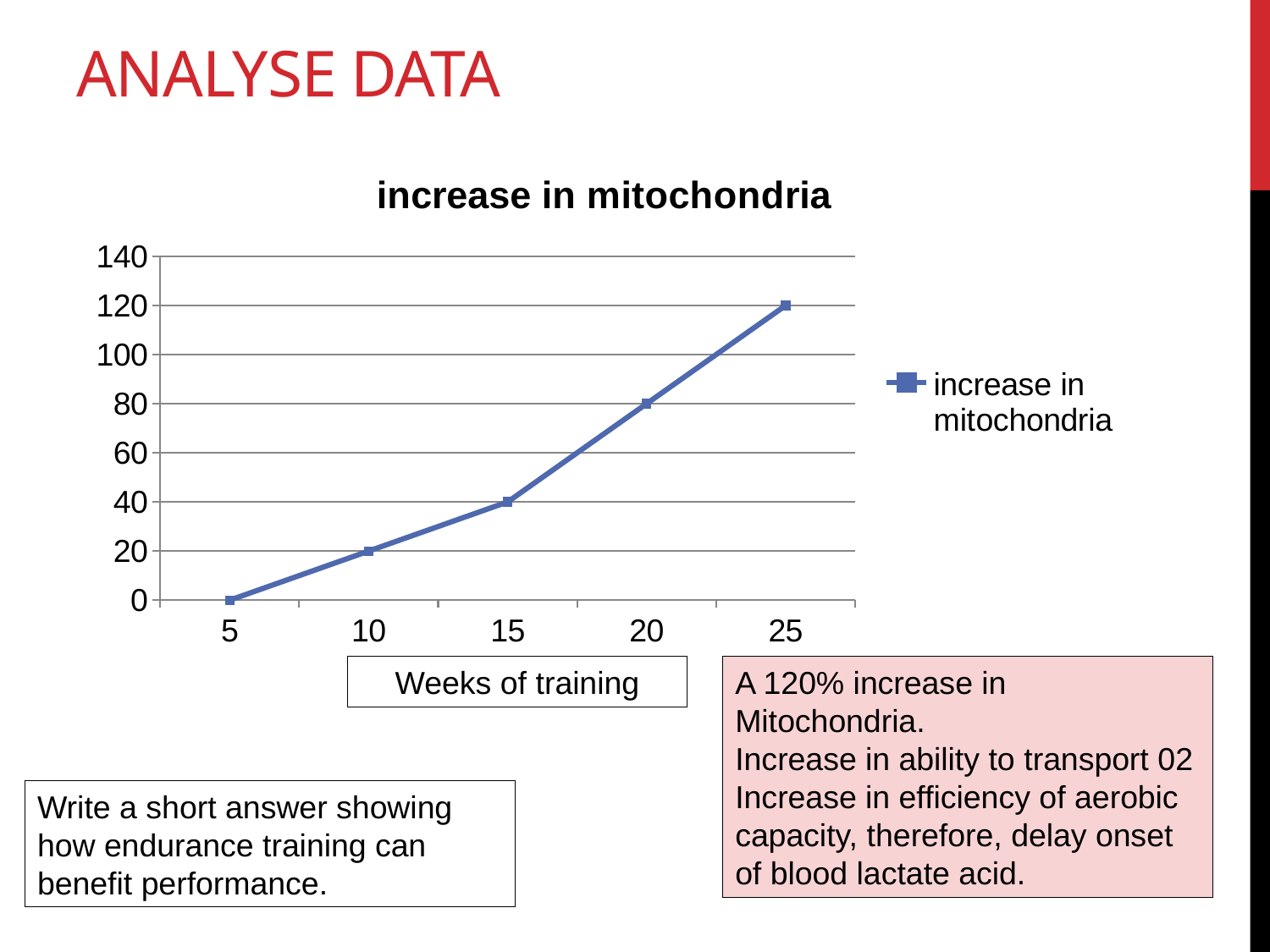
What is the value for increase in mitochondria at 15 weeks of training? 40 What is the value for increase in mitochondria at 5 weeks of training? 0 What is the title of the chart? increase in mitochondria At which number of weeks of training is the increase in mitochondria highest? 25 Which is larger, the value at 20 weeks or the value at 15 weeks of training? 20 weeks What is the difference between the values at 20 weeks and 10 weeks of training? 60 Do the values rise or fall as the weeks of training increase? rise What is the value for increase in mitochondria at 25 weeks of training? 120 How many series does the legend list? 1 How many data points are plotted on the line? 5 What kind of chart is shown on the slide? line chart At which number of weeks of training is the increase in mitochondria lowest? 5